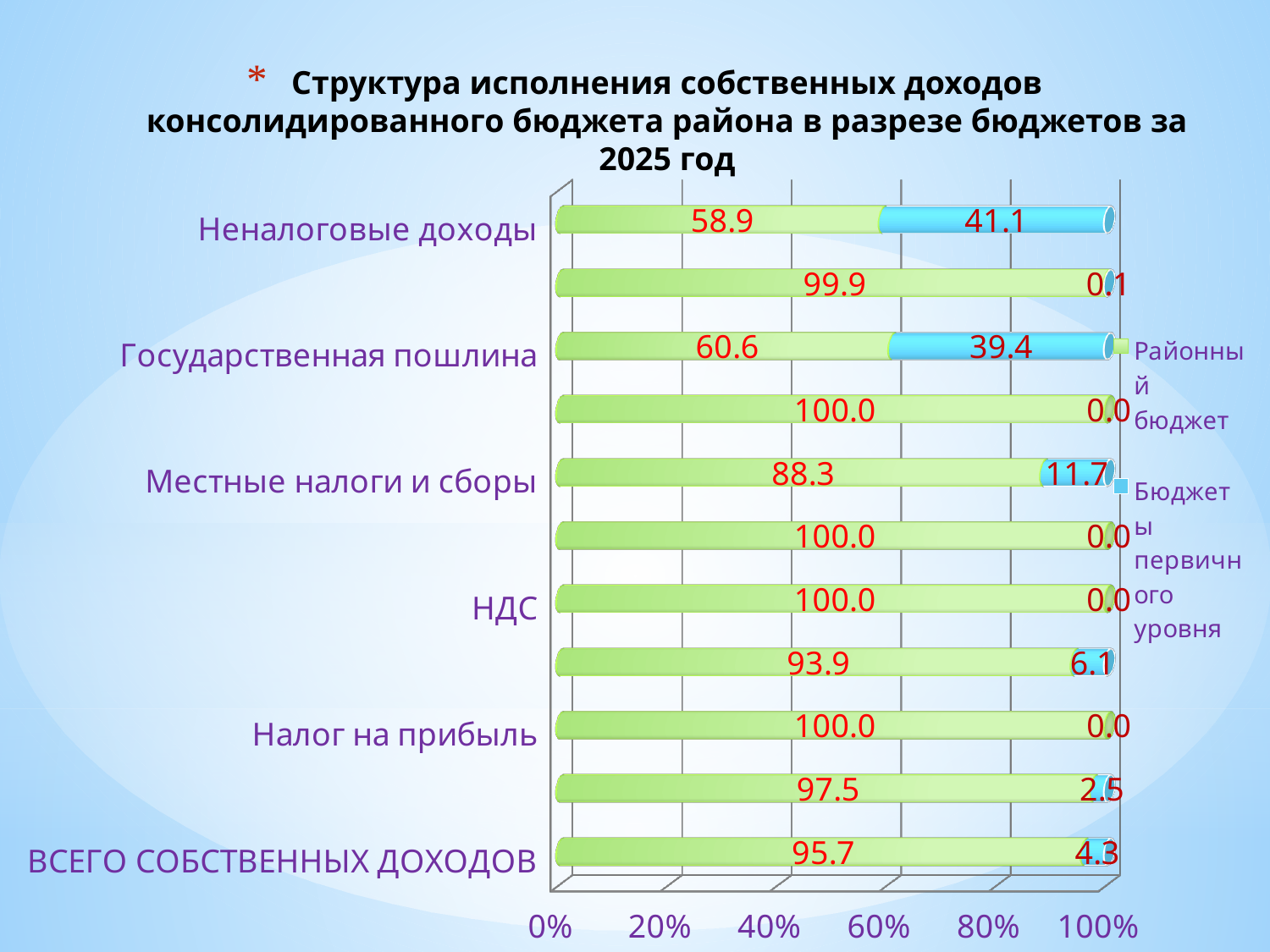
How many series does the legend list? 2 What type of chart is shown on the slide? Stacked bar chart What is the value of Районный бюджет for Неналоговые доходы? 58.9 What is the value of Бюджеты первичного уровня for НДС? 0.0 Among the labelled categories, which has the lowest Районный бюджет value? Неналоговые доходы What is the value of Районный бюджет for Местные налоги и сборы? 88.3 What is the value of Районный бюджет for ВСЕГО СОБСТВЕННЫХ ДОХОДОВ? 95.7 Which series is shown in green? Районный бюджет What is the value of Бюджеты первичного уровня for Неналоговые доходы? 41.1 Which is larger for Государственная пошлина: Районный бюджет or Бюджеты первичного уровня? Районный бюджет What is the difference between the Районный бюджет values for Местные налоги и сборы and Неналоговые доходы? 29.4 What is the value of Бюджеты первичного уровня for Государственная пошлина? 39.4